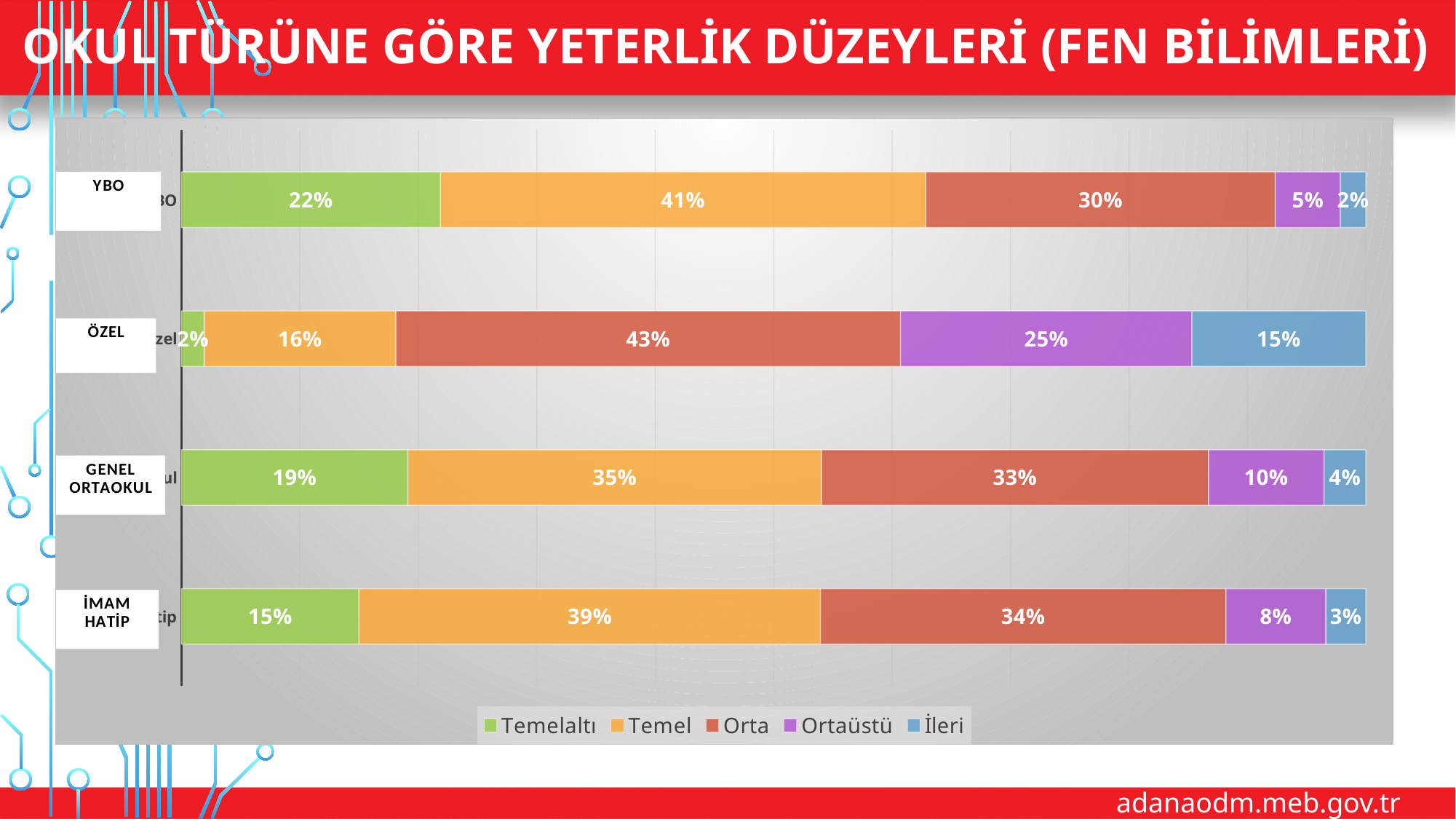
What is the İleri value for GENEL ORTAOKUL? 4% How many school types are shown in the chart? 4 What is the Temel value for YBO? 41% Which school type has the highest Temelaltı value? YBO What is the difference between the Ortaüstü values for ÖZEL and GENEL ORTAOKUL? 15% What is the Ortaüstü value for İMAM HATİP? 8% What kind of chart is shown on the slide? Stacked bar chart What is the total of the Temelaltı and Temel segments for ÖZEL? 18% How many series does the legend list? 5 What is the Orta value for ÖZEL? 43% Which school type has the lowest İleri value? YBO Which is larger, the Temel value for İMAM HATİP or the Temel value for GENEL ORTAOKUL? İMAM HATİP